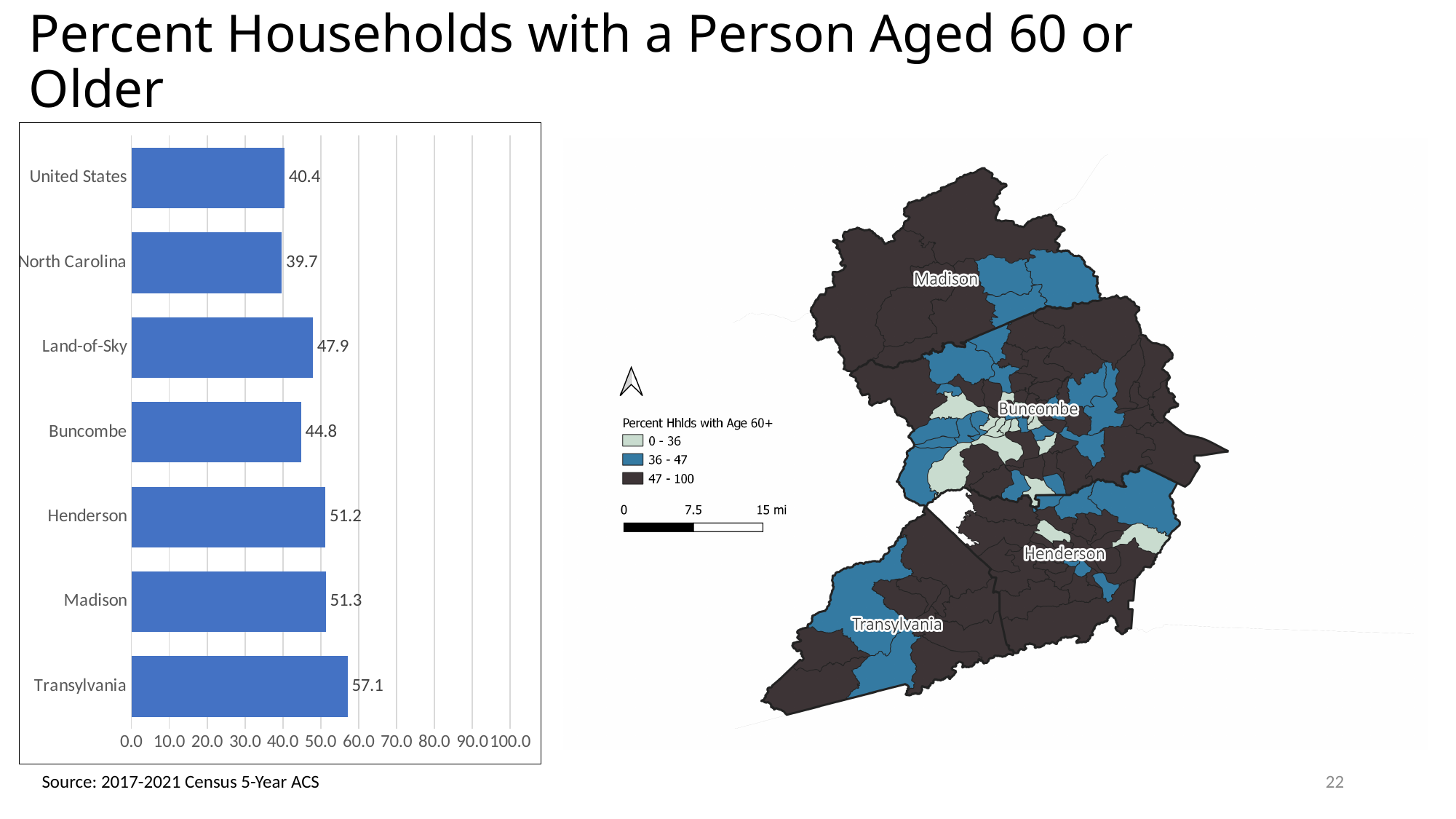
What is the value for North Carolina in the bar chart? 39.7 Which is larger in the bar chart, the value for Henderson or the value for Buncombe? Henderson What is the title of the map legend on the right of the slide? Percent Hhlds with Age 60+ Which category has the lowest value in the bar chart? North Carolina What is the difference between the values for United States and North Carolina in the bar chart? 0.7 What is the value for Transylvania in the bar chart? 57.1 Which category has the highest value in the bar chart? Transylvania What is the value for Land-of-Sky in the bar chart? 47.9 How many categories are shown in the bar chart? 7 What is the difference between the values for Transylvania and Buncombe in the bar chart? 12.3 What kind of chart is shown on the left of the slide? bar chart Is the value for Madison in the bar chart greater or less than 50.0? greater